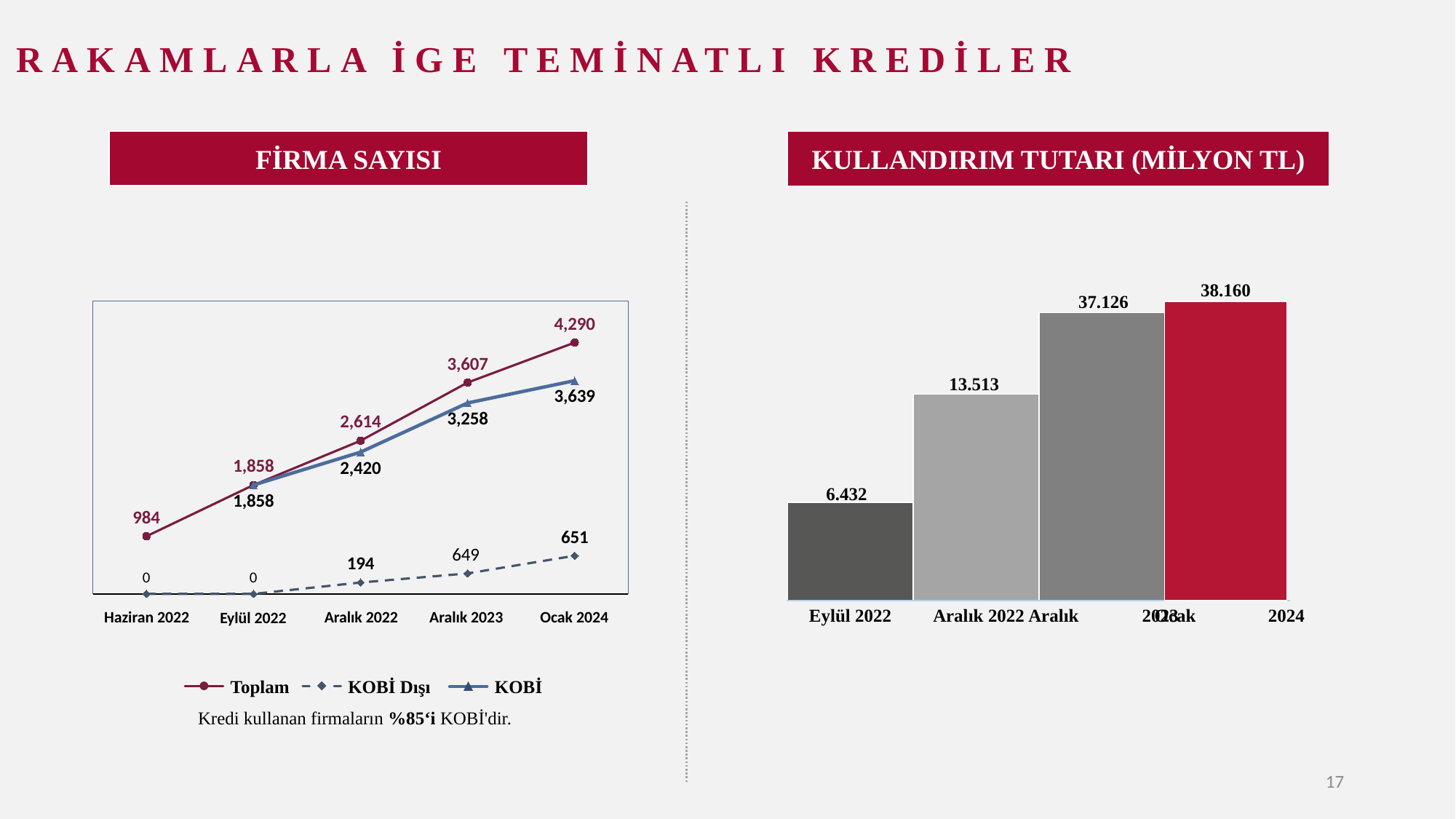
In the FİRMA SAYISI chart, how many time points are shown on the x axis? 5 In the FİRMA SAYISI chart, what is the Toplam value for Ocak 2024? 4,290 In the FİRMA SAYISI chart, what is the KOBİ value for Aralık 2023? 3,258 In the KULLANDIRIM TUTARI (MİLYON TL) chart, what is the value for Eylül 2022? 6.432 In the KULLANDIRIM TUTARI (MİLYON TL) chart, which period has the highest value? Ocak 2024 What kind of chart is the KULLANDIRIM TUTARI (MİLYON TL) chart? bar chart In the KULLANDIRIM TUTARI (MİLYON TL) chart, what is the difference between the Aralık 2022 and Eylül 2022 values? 7.081 In the KULLANDIRIM TUTARI (MİLYON TL) chart, which bar is shown in red? Ocak 2024 In the FİRMA SAYISI chart, what is the KOBİ Dışı value for Aralık 2022? 194 In the FİRMA SAYISI chart, does the Toplam series rise or fall from Haziran 2022 to Ocak 2024? rise In the FİRMA SAYISI chart, what is the difference between the Toplam and KOBİ values for Ocak 2024? 651 In the FİRMA SAYISI chart, how many series does the legend list? 3